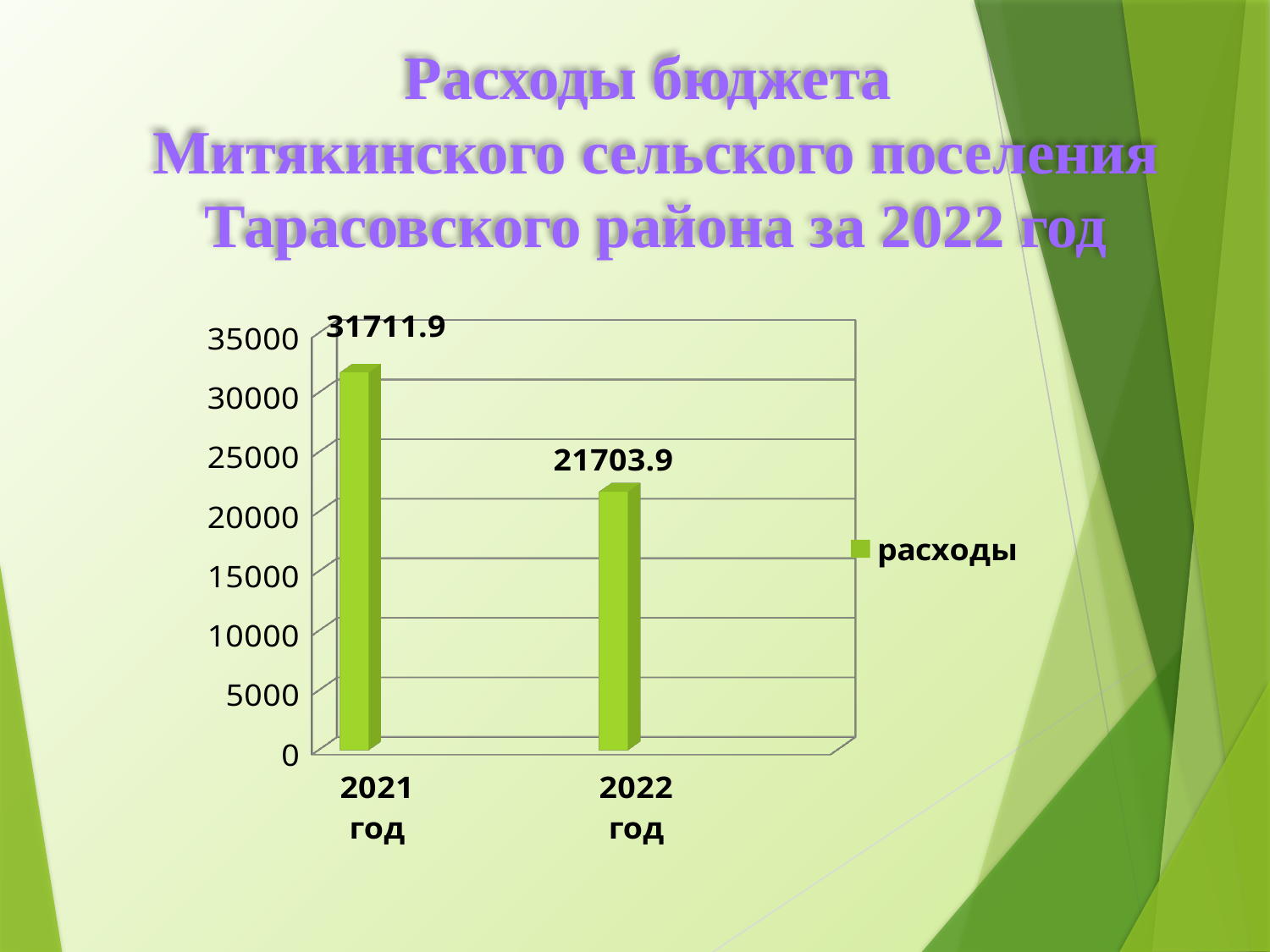
Is the value for 2022 год greater or less than 25000? less How many series does the legend list? 1 What is the value for 2022 год? 21703.9 Which year has the lowest value? 2022 год What kind of chart is shown on the slide? bar chart What is the value for 2021 год? 31711.9 Is the value for 2021 год greater or less than 30000? greater Which year has the highest value? 2021 год Which is larger, the value for 2021 год or the value for 2022 год? 2021 год How many categories are shown on the x axis? 2 What is the difference between the values for 2021 год and 2022 год? 10008 What is the name of the series in the legend? расходы